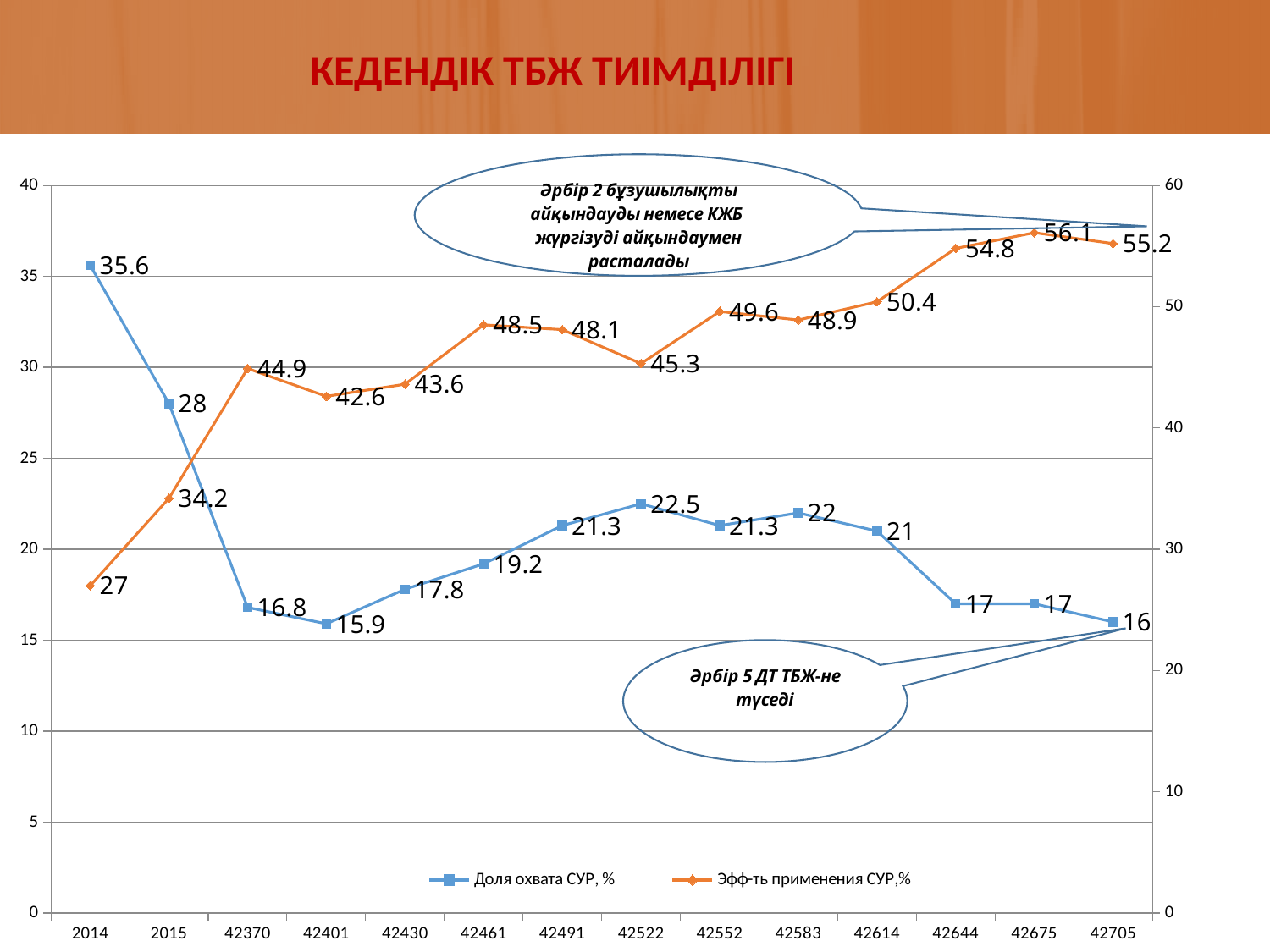
Which is larger: the Эфф-ть применения СУР,% value for 42644 or for 42705? 42705 How many categories are shown on the x axis? 14 Does the Эфф-ть применения СУР,% series generally rise or fall from 2014 to 42705? rise What is the value of Доля охвата СУР, % for 2014? 35.6 How many series does the legend list? 2 Which category has the highest value for Эфф-ть применения СУР,%? 42675 What is the value of Доля охвата СУР, % for 42401? 15.9 Which category has the lowest value for Доля охвата СУР, %? 42401 What colour is the line for Доля охвата СУР, %? blue What is the difference between the Доля охвата СУР, % values for 2014 and 2015? 7.6 What type of chart is shown on the slide? line chart What is the value of Эфф-ть применения СУР,% for 42675? 56.1